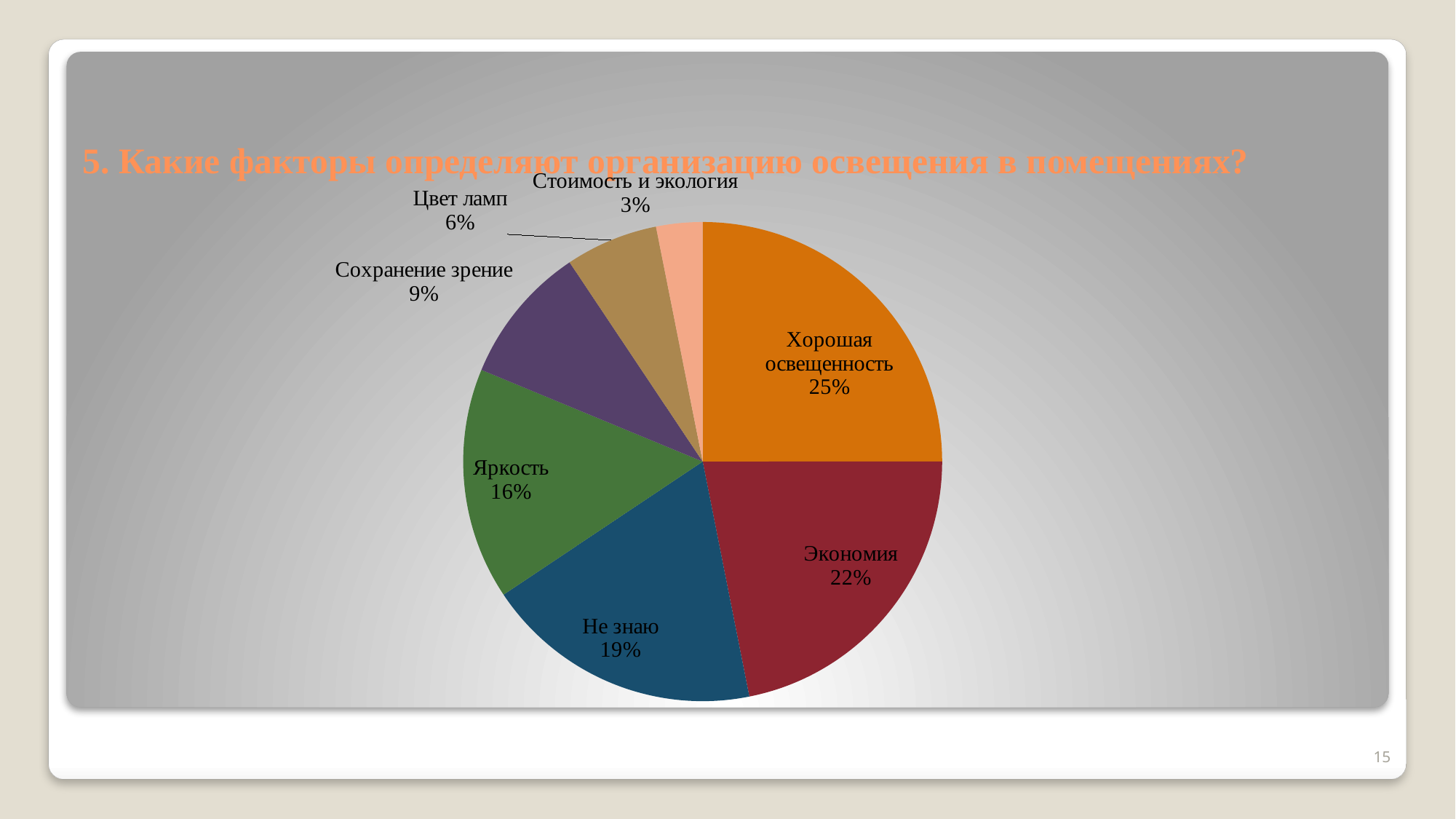
Which is larger, the slice for "Не знаю" or the slice for "Сохранение зрение"? Не знаю How many categories (slices) does the pie chart have? 7 What is the value shown for "Цвет ламп"? 6% What is the value shown for "Не знаю"? 19% What is the value shown for "Яркость"? 16% What is the value shown for "Экономия"? 22% What share of the pie does "Хорошая освещенность" have? 25% What is the difference in percentage points between "Экономия" and "Яркость"? 6 Which category has the largest slice of the pie? Хорошая освещенность What kind of chart is shown on the slide? pie chart Which category has the smallest slice of the pie? Стоимость и экология What is the value shown for "Сохранение зрение"? 9%